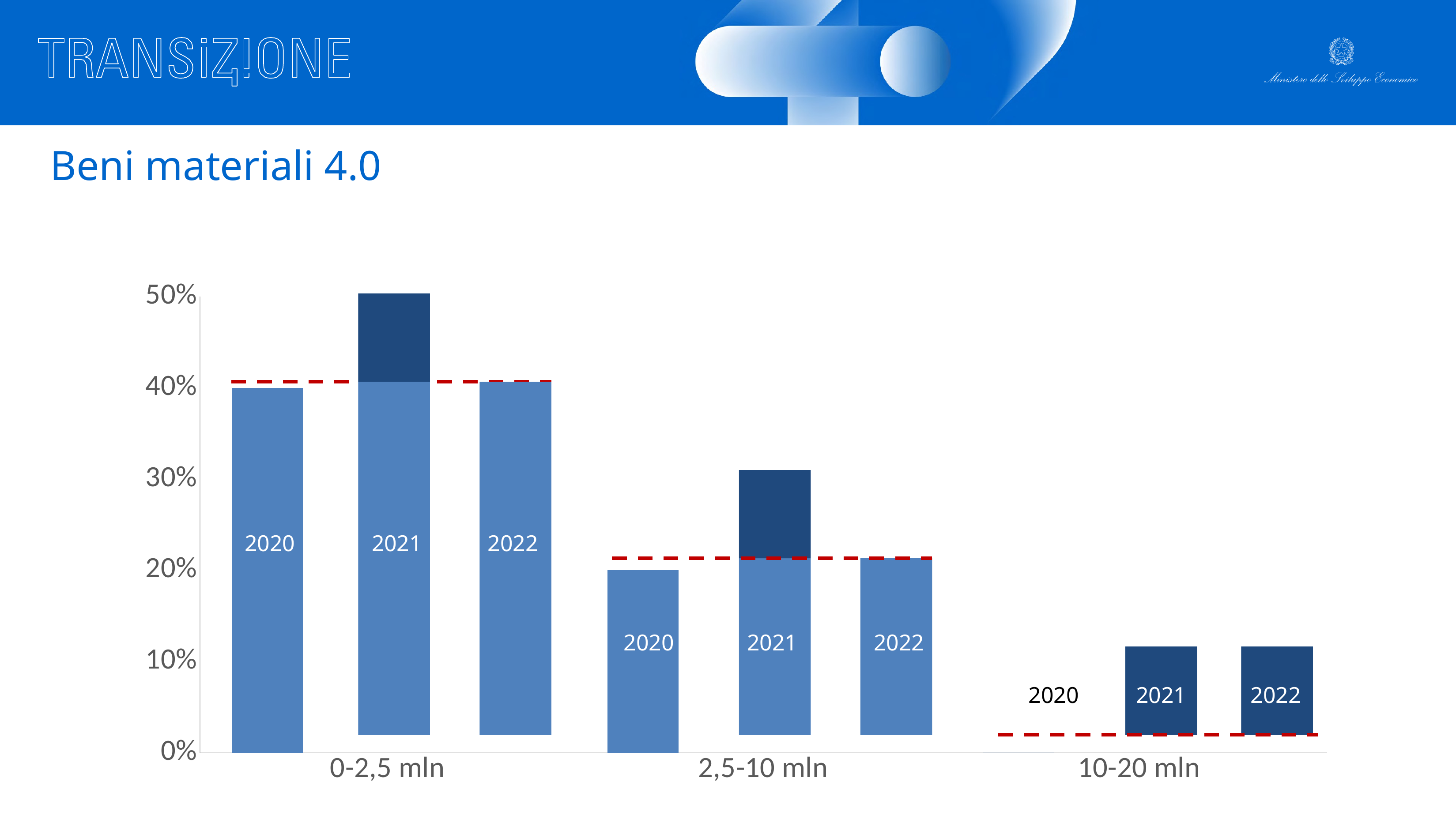
What kind of chart is shown on the slide? bar chart Which category contains the tallest bar in the chart? 0-2,5 mln What is the value of the 2021 bar in the 2,5-10 mln category? 30% What is the title of the chart? Beni materiali 4.0 What is the value of the 2020 bar in the 2,5-10 mln category? 20% What is the difference between the 2021 and 2020 values in the 0-2,5 mln category? 10% Is the value for 2021 in the 0-2,5 mln category greater or less than 40%? greater What is the value of the 2020 bar in the 0-2,5 mln category? 40% How many investment-size categories are shown on the x axis? 3 In the 2,5-10 mln category, which bar is taller, 2020 or 2021? 2021 What is the value of the 2021 bar in the 0-2,5 mln category? 50% Is the value for 2022 in the 10-20 mln category greater or less than 20%? less